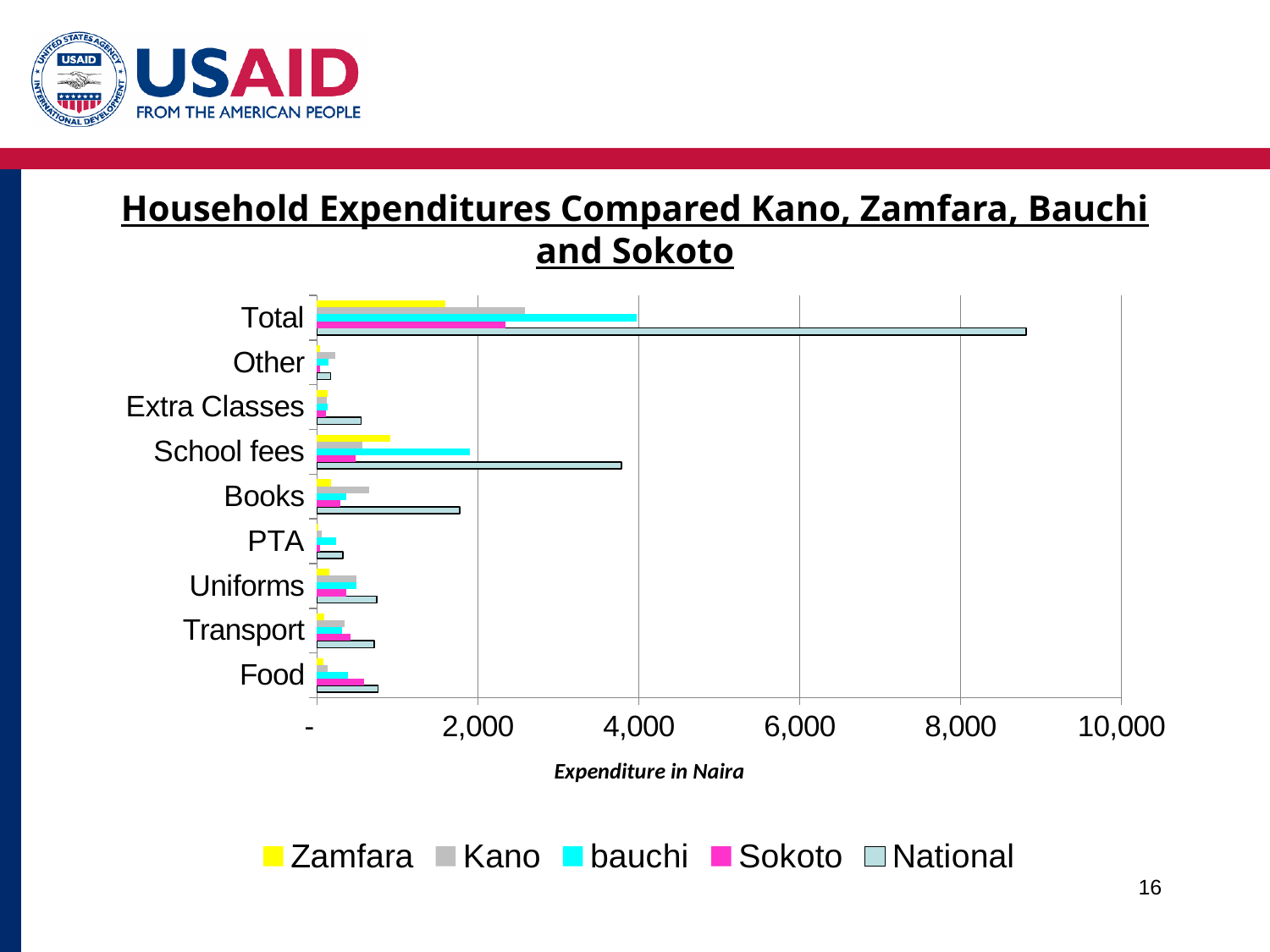
How many expenditure categories are shown on the vertical axis? 9 Excluding Total, which category has the longest National bar? School fees How many series does the legend list? 5 What is the title of the horizontal axis? Expenditure in Naira For the Total category, which is larger: Kano or Zamfara? Kano Is the Kano value for Total greater or less than 2,000? greater For the National series, which is larger: School fees or Books? School fees Is the Zamfara value for Total greater or less than 2,000? less What kind of chart is shown on the slide? bar chart Which series has the longest bar for the Total category? National Is the National value for School fees greater or less than 4,000? less